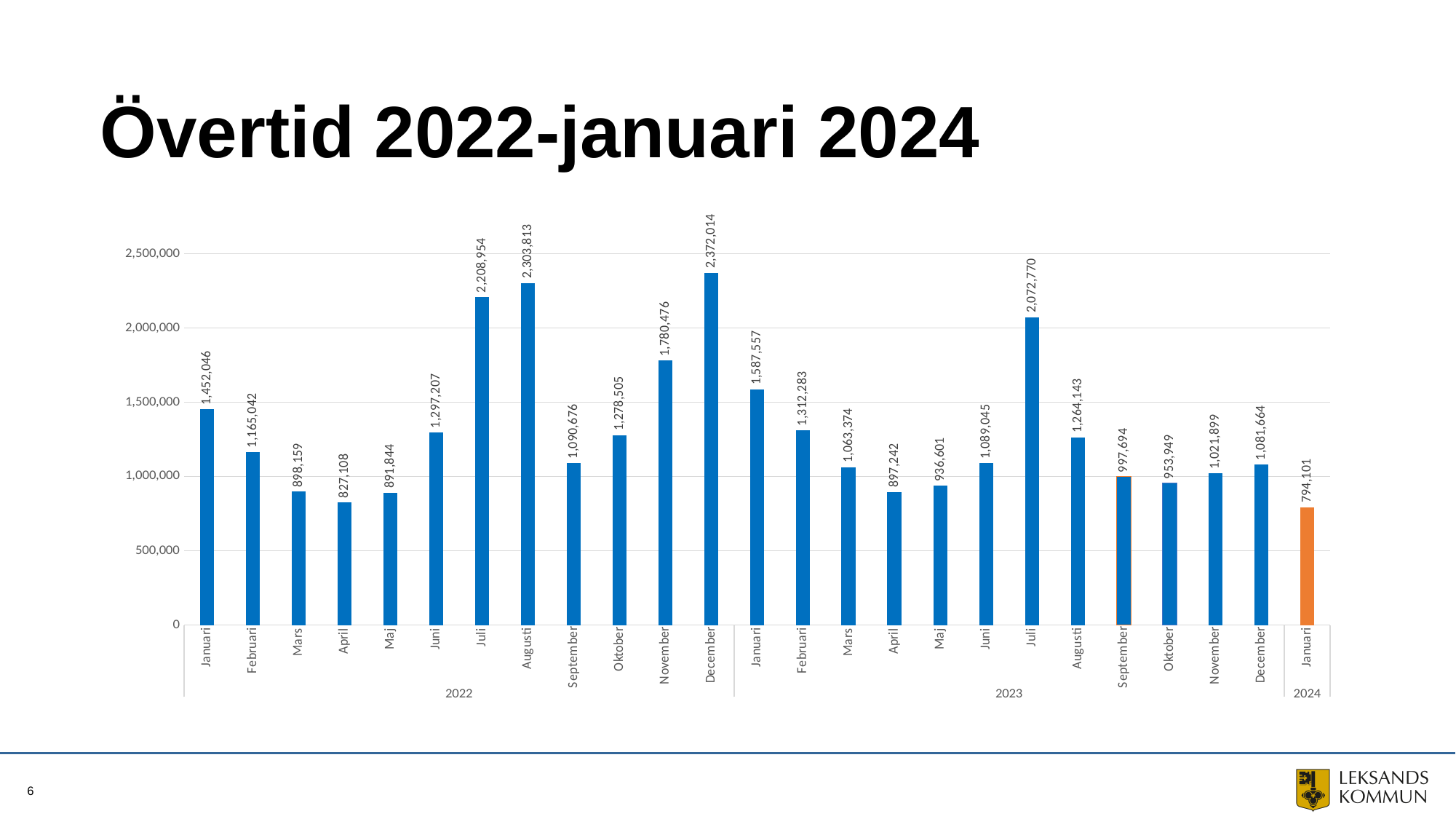
How many monthly bars are plotted in the chart? 25 What is the value for Juli 2023? 2,072,770 What is the value for Augusti 2022? 2,303,813 Which month has the highest value in the chart? December 2022 What kind of chart is shown on the slide? bar chart What is the difference between December 2022 and Juli 2022? 163,060 Which is larger, Juli 2022 or Juli 2023? Juli 2022 What is the value for Januari 2024? 794,101 What is the difference between Januari 2023 and Januari 2024? 793,456 Which bar is coloured orange instead of blue? Januari 2024 Which month has the lowest value in the chart? Januari 2024 Is the value for November 2022 greater or less than 1,500,000? greater